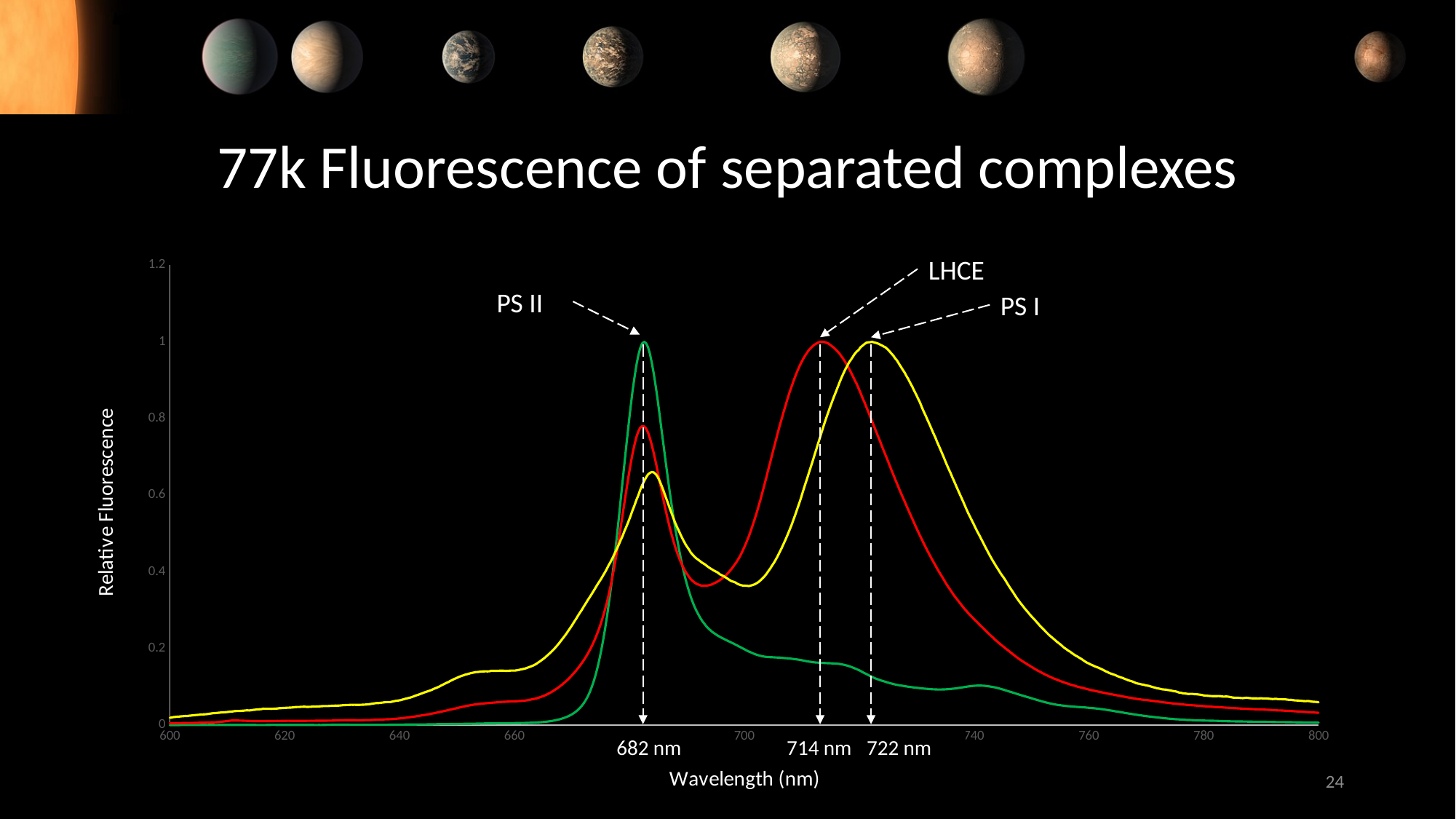
At what wavelength does the LHCE curve peak? 714 nm What kind of chart is shown on the slide? line chart At what wavelength does the PS I curve peak? 722 nm Is the value of the green PS II curve at 700 nm greater or less than 0.4? less Is the value of the red LHCE curve at 682 nm greater or less than 0.6? greater At 682 nm, which curve is higher, the green PS II curve or the red LHCE curve? PS II (green) What is the title of the chart? 77k Fluorescence of separated complexes Does the yellow PS I curve rise or fall between 722 nm and 800 nm? fall What is the label of the y axis? Relative Fluorescence How many curves are plotted on the chart? 3 Which of the three labelled complexes has its peak at the shortest wavelength? PS II At what wavelength does the PS II curve peak? 682 nm